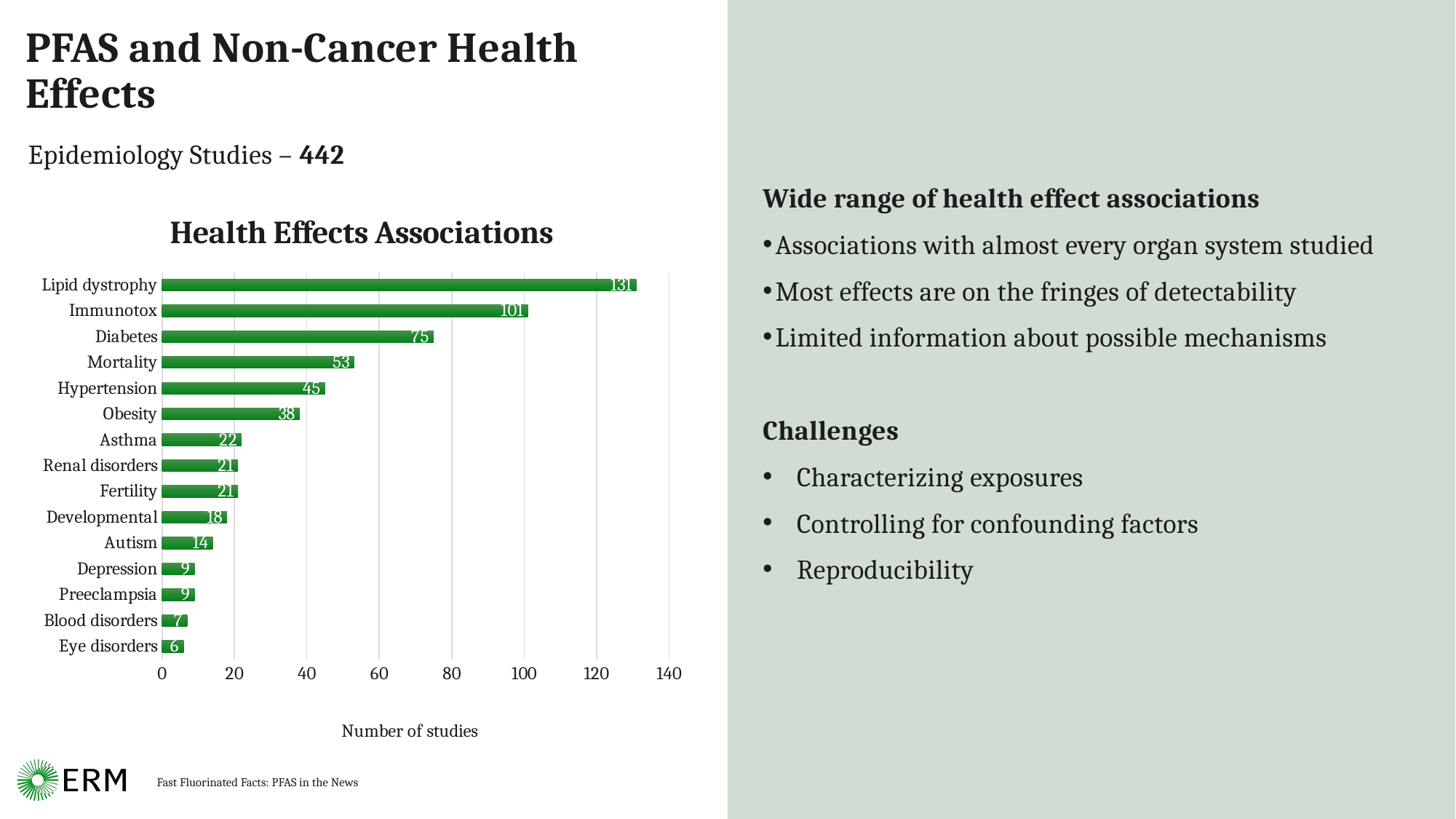
What is the label of the x axis of the chart? Number of studies What is the number of studies for Diabetes? 75 Is the value for Immunotox greater or less than 100? greater What is the number of studies for Hypertension? 45 Which health effect has the highest number of studies? Lipid dystrophy Which health effect has the lowest number of studies? Eye disorders Which has more studies, Asthma or Developmental? Asthma What is the number of studies for Autism? 14 What is the difference in number of studies between Lipid dystrophy and Immunotox? 30 What type of chart is used to show the Health Effects Associations? Bar chart How many health effect categories are shown in the chart? 15 What is the difference in number of studies between Mortality and Obesity? 15